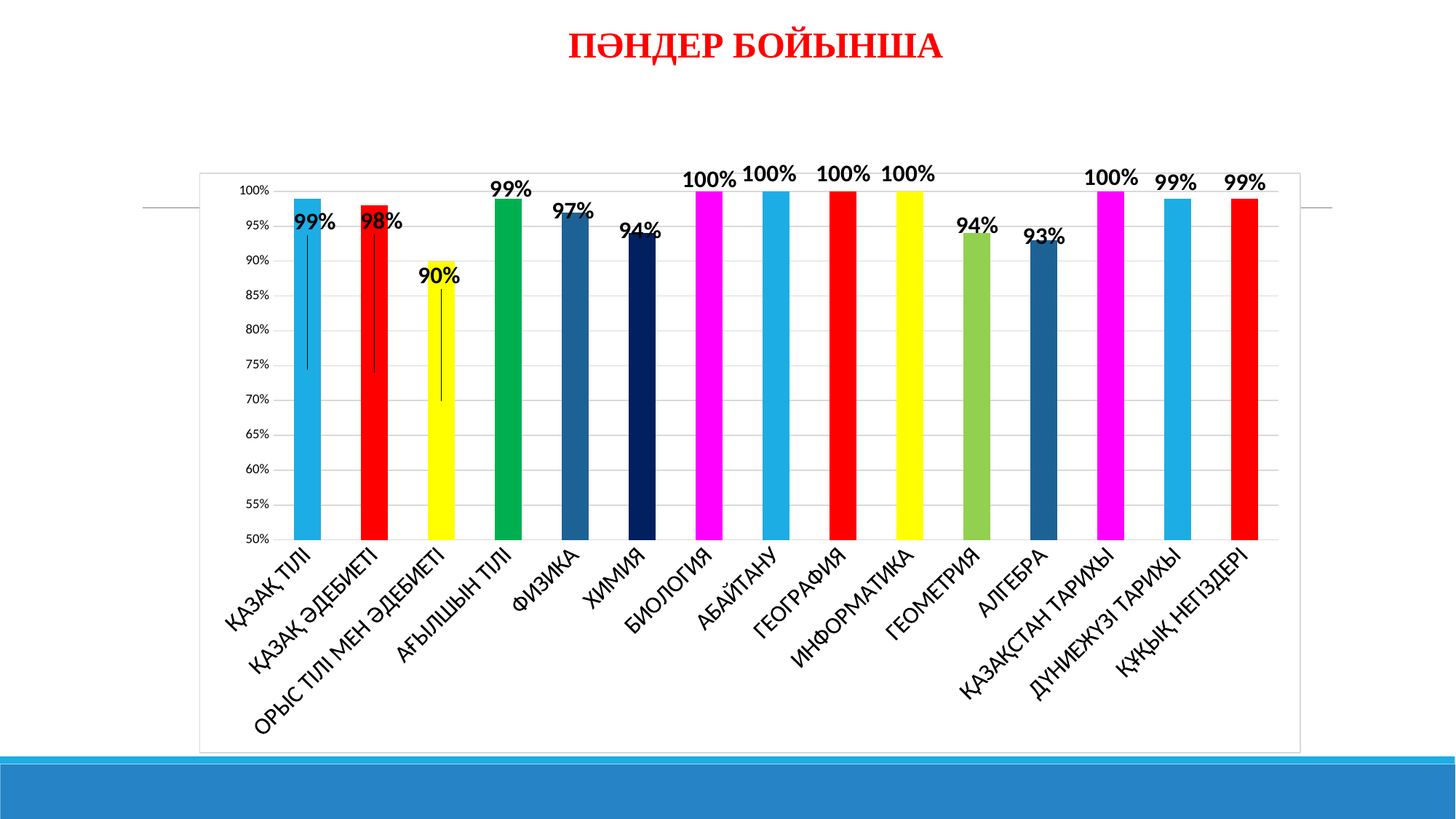
What is the value for ОРЫС ТІЛІ МЕН ӘДЕБИЕТІ? 90% Is the value for ГЕОМЕТРИЯ greater or less than 90%? greater How many categories are shown on the x axis? 15 What is the title of the slide? ПӘНДЕР БОЙЫНША What is the value for АЛГЕБРА? 93% Which category has the lowest value? ОРЫС ТІЛІ МЕН ӘДЕБИЕТІ What is the value for ҚАЗАҚ ӘДЕБИЕТІ? 98% What is the difference between the values for БИОЛОГИЯ and АЛГЕБРА? 7% What is the value for ФИЗИКА? 97% What is the difference between the values for ҚАЗАҚ ТІЛІ and ОРЫС ТІЛІ МЕН ӘДЕБИЕТІ? 9% Which is larger, the value for ХИМИЯ or the value for ФИЗИКА? ФИЗИКА What type of chart is shown on the slide? bar chart